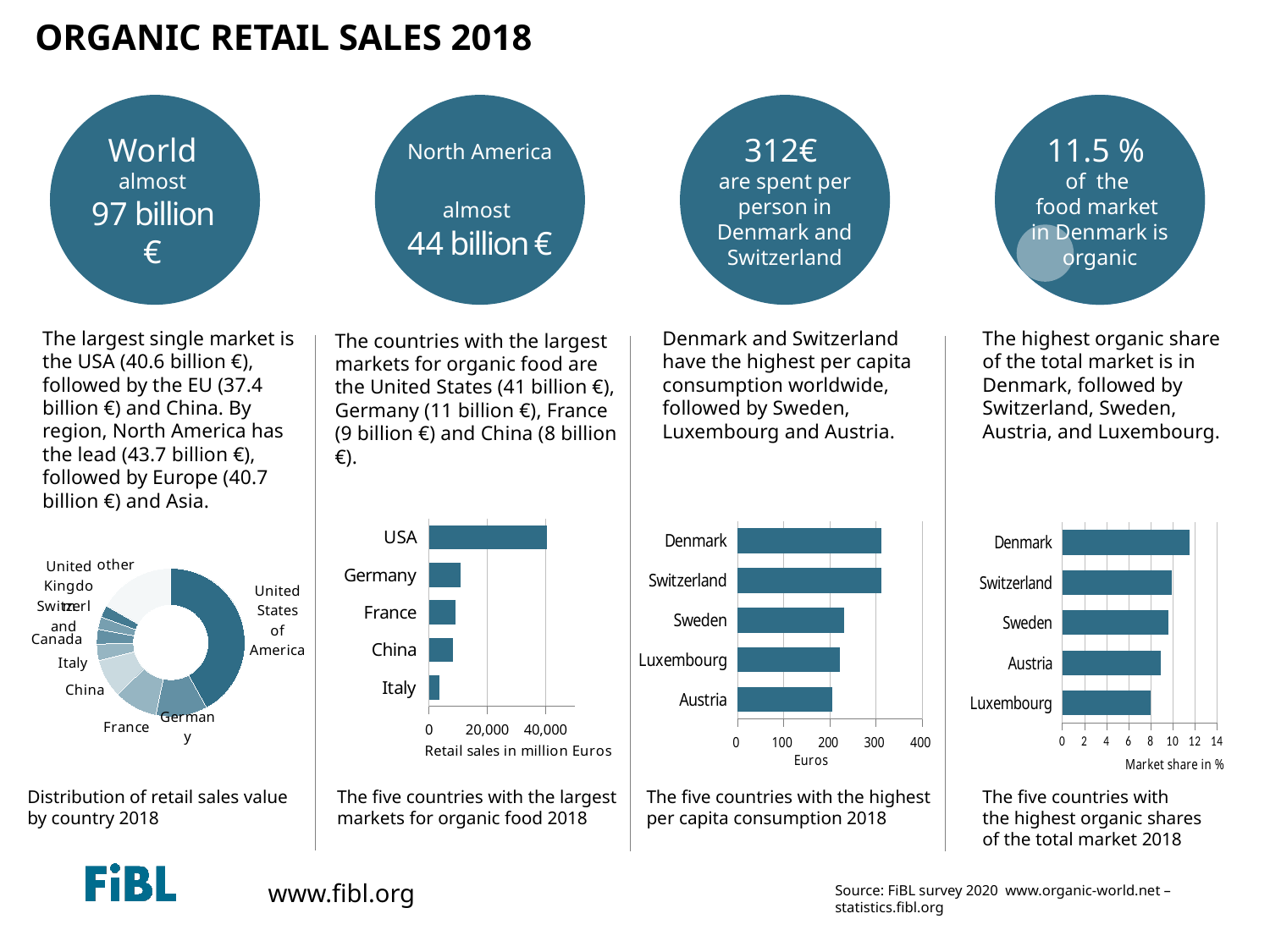
How many countries are shown in the chart 'The five countries with the highest per capita consumption 2018'? 5 What kind of chart is the 'Distribution of retail sales value by country 2018' chart? doughnut chart In the chart 'The five countries with the highest per capita consumption 2018', is the value for Denmark greater or less than 300? greater In the chart 'The five countries with the largest markets for organic food 2018', is the value for Germany greater or less than 20,000? less In the chart 'The five countries with the largest markets for organic food 2018', which country has the highest retail sales? USA In the chart 'The five countries with the highest per capita consumption 2018', which has a higher value, Sweden or Austria? Sweden In the chart 'The five countries with the highest organic shares of the total market 2018', which country has the lowest market share? Luxembourg In the chart 'The five countries with the highest organic shares of the total market 2018', is the value for Denmark greater or less than 10? greater In the chart 'The five countries with the highest organic shares of the total market 2018', which country has the highest market share? Denmark In the chart 'The five countries with the largest markets for organic food 2018', which country has the lowest retail sales? Italy In the chart 'The five countries with the largest markets for organic food 2018', which has larger retail sales, Germany or France? Germany In the 'Distribution of retail sales value by country 2018' chart, which country has the largest slice? United States of America